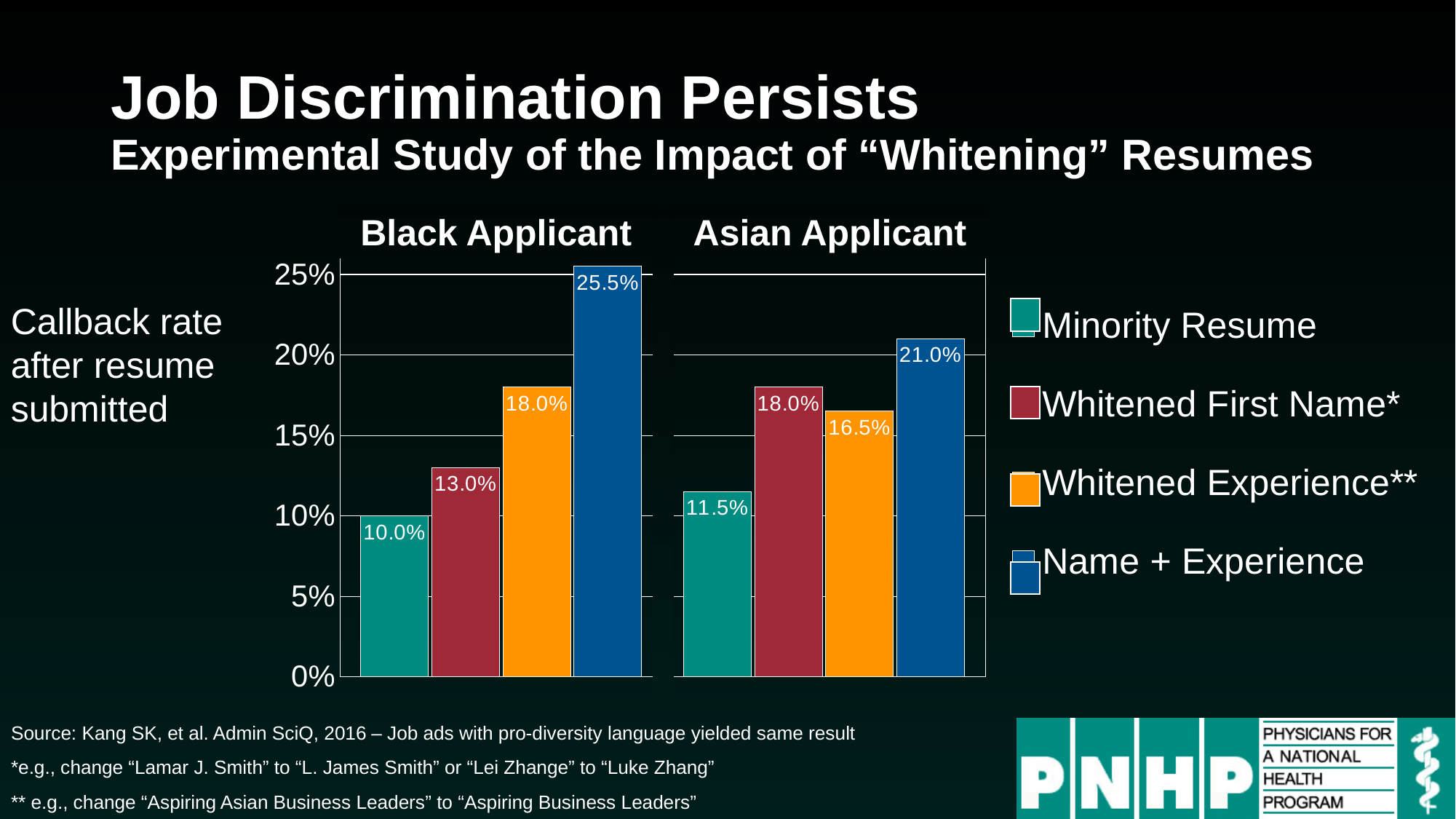
What is the difference between the Whitened First Name and Whitened Experience callback rates for Asian applicants? 1.5% What is the difference between the Name + Experience callback rate and the Minority Resume callback rate for Black applicants? 15.5% What is the callback rate for an Asian applicant with Whitened Experience? 16.5% Which is larger: the Name + Experience callback rate for Black applicants or for Asian applicants? Black applicants Which resume type has the highest callback rate for Black applicants? Name + Experience How many series does the legend list? 4 What is the callback rate for a Black applicant with a Minority Resume? 10.0% What kind of chart is shown on the slide? Bar chart Which resume type has the lowest callback rate for Asian applicants? Minority Resume Is the Whitened First Name callback rate for Black applicants greater or less than 15%? less What is the callback rate for an Asian applicant with Name + Experience whitened? 21.0% What does the legend entry shown in orange represent? Whitened Experience**